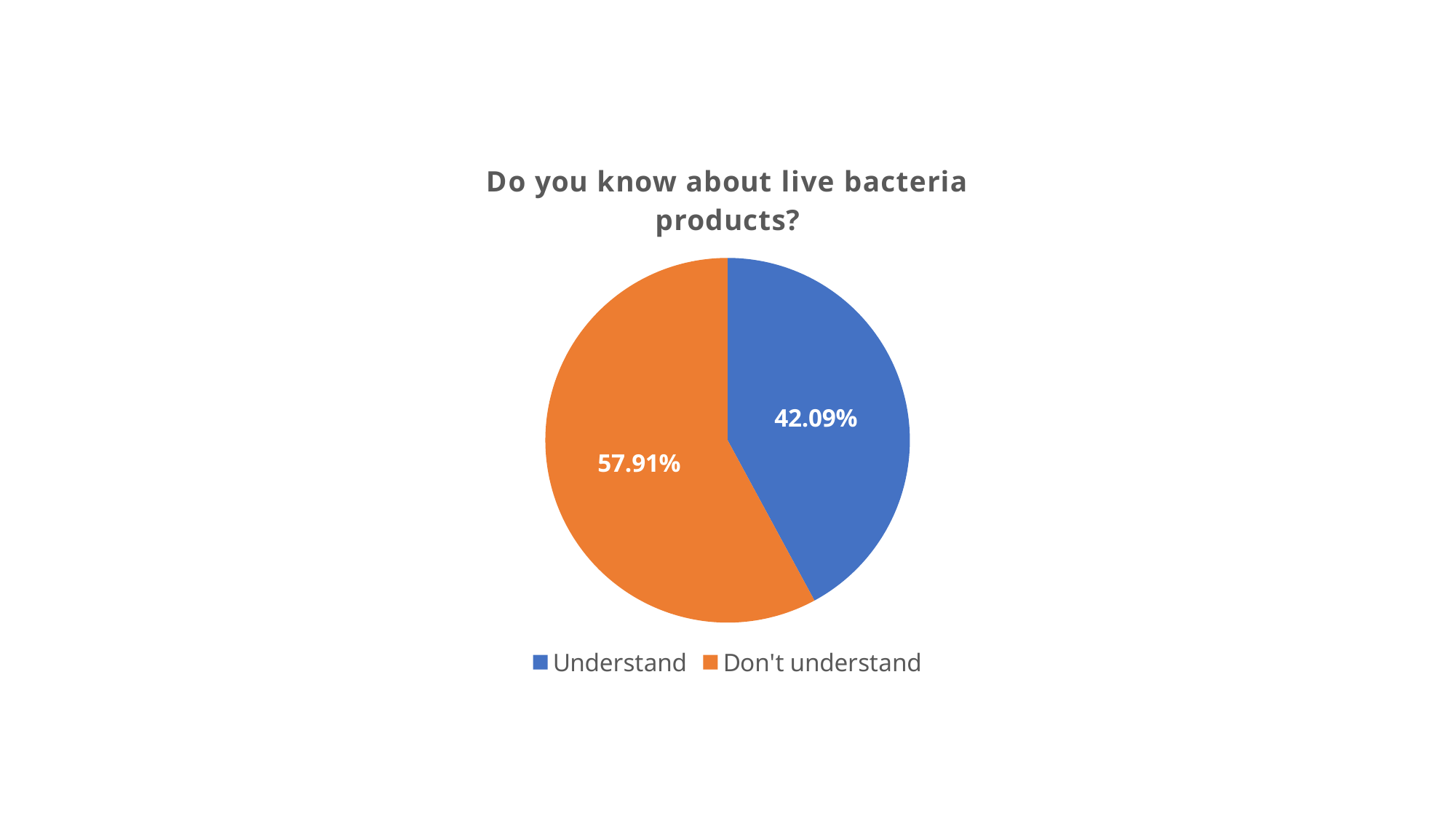
What colour is the "Don't understand" slice? Orange What share of the pie does the "Understand" slice represent? 42.09% Is the share for "Understand" greater or less than 50%? less What kind of chart is shown on the slide? Pie chart What is the title of the chart? Do you know about live bacteria products? What percentage of respondents answered "Understand"? 42.09% What percentage of respondents answered "Don't understand"? 57.91% Which is larger, the share for "Understand" or the share for "Don't understand"? Don't understand What is the difference in percentage points between "Don't understand" and "Understand"? 15.82 How many categories are shown in the pie chart? 2 Which category has the largest share of the pie? Don't understand Which category has the smallest share of the pie? Understand